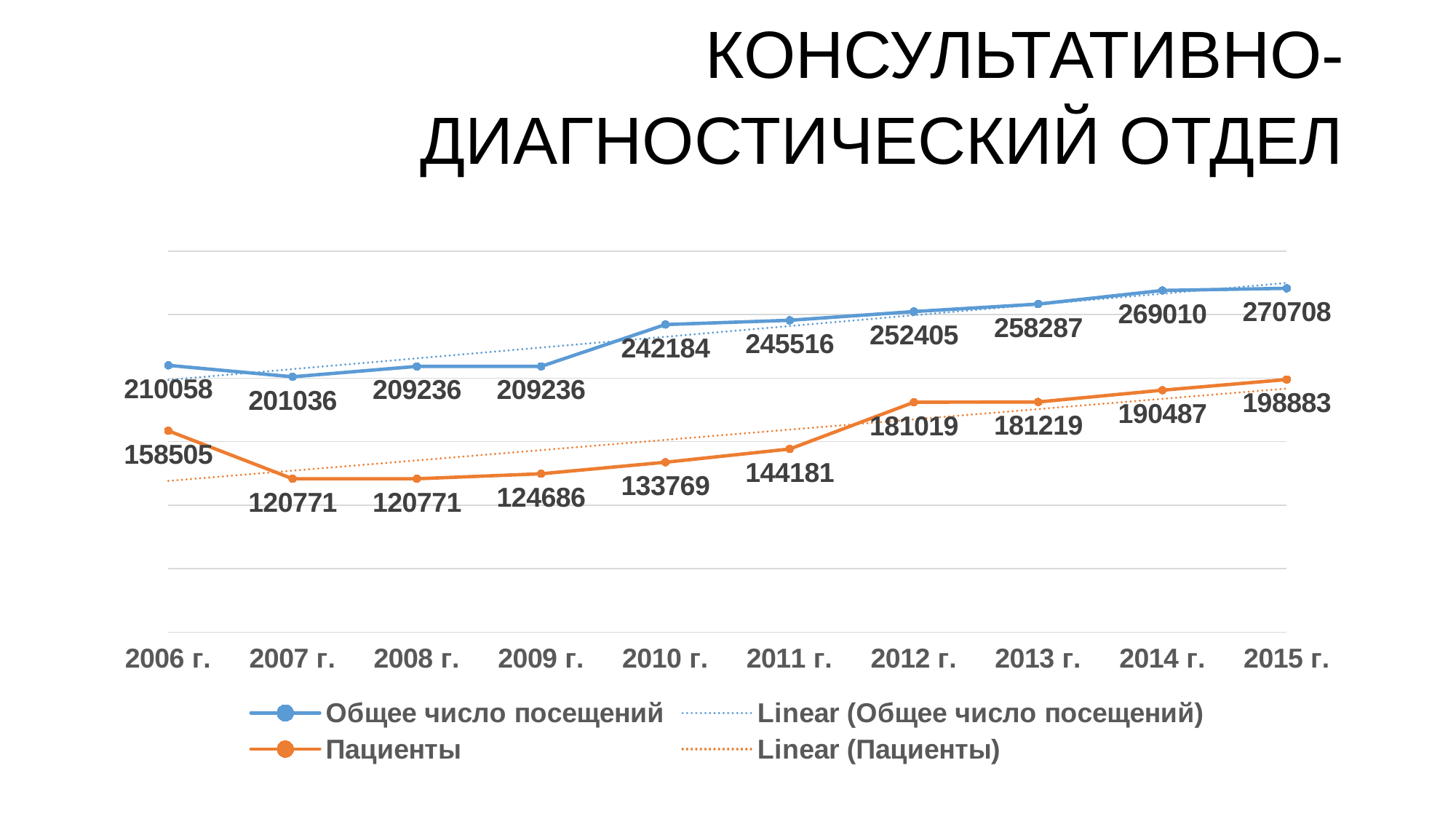
Which is larger: Пациенты in 2011 г. or Пациенты in 2012 г.? 2012 г. What is the difference between Общее число посещений and Пациенты in 2015 г.? 71825 In which year is Общее число посещений lowest? 2007 г. What is the value of Общее число посещений for 2010 г.? 242184 By how much did Общее число посещений increase from 2006 г. to 2015 г.? 60650 How many years are shown on the x axis? 10 What is the value of Пациенты for 2012 г.? 181019 What type of chart is shown on the slide? Line chart What is the highest value of Пациенты shown? 198883 In which year is Общее число посещений highest? 2015 г. What is the value of Пациенты for 2006 г.? 158505 How many entries does the legend list? 4